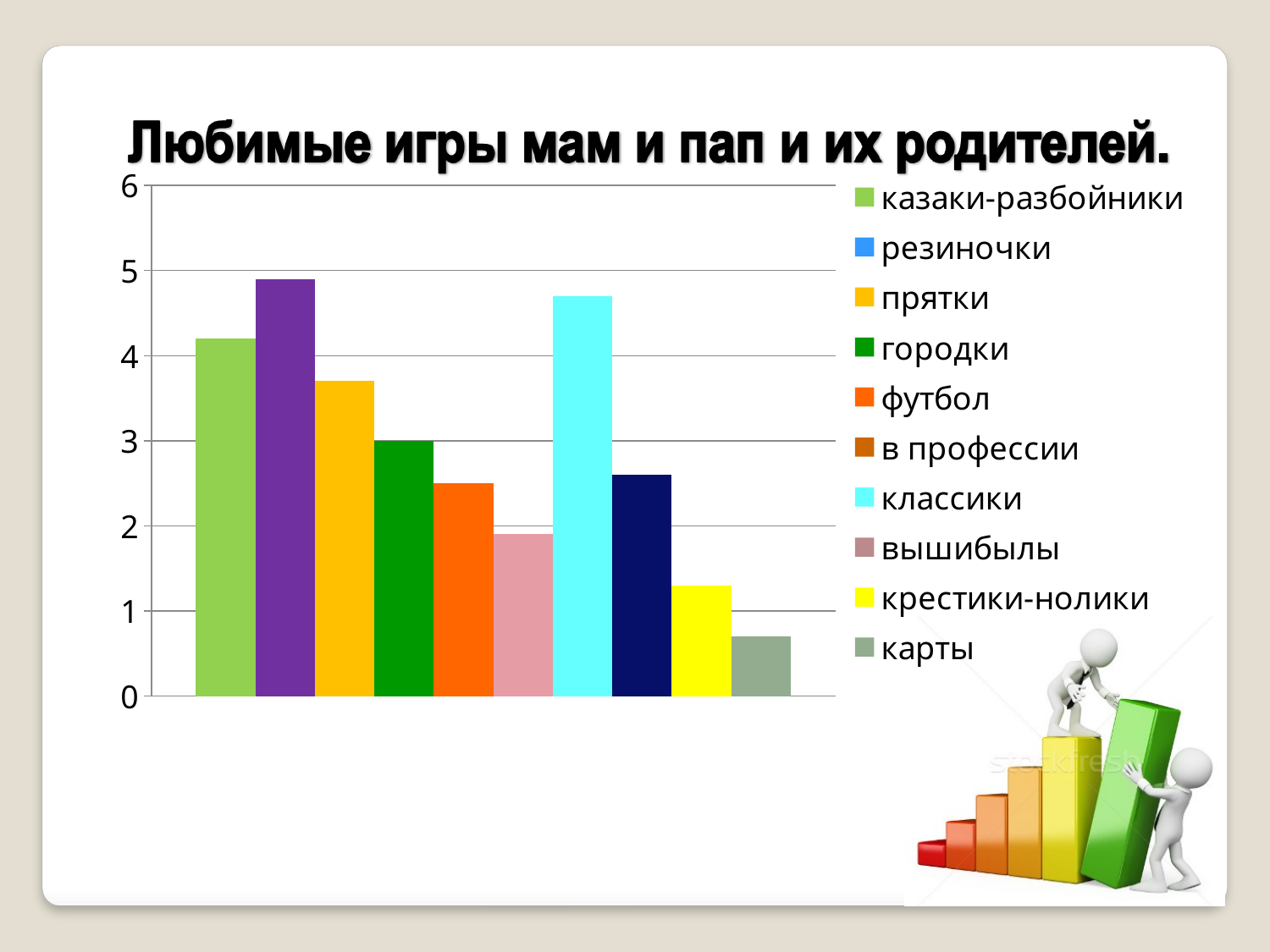
What kind of chart is shown on the slide? bar chart How many bars are plotted in the chart? 10 What is the title of the chart? Любимые игры мам и пап и их родителей. Is the value for классики greater or less than 4? greater Which has the larger value, футбол or крестики-нолики? футбол Is the value for прятки greater or less than 3? greater Which game has the lowest bar in the chart? карты Is the value for казаки-разбойники greater or less than 4? greater How many entries does the chart legend list? 10 Which has the larger value, казаки-разбойники or прятки? казаки-разбойники